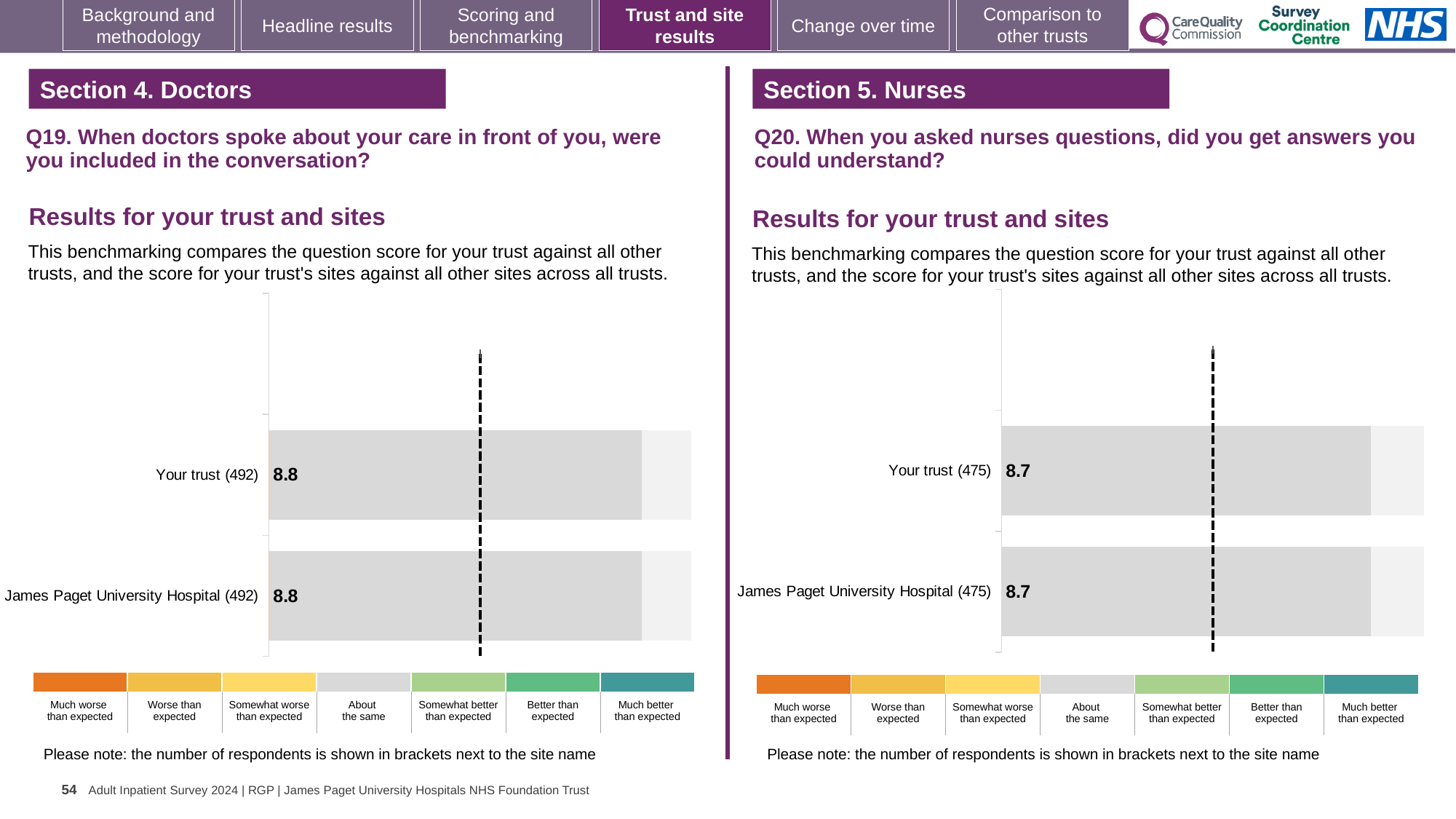
On the Q20 nurses chart (right), how many bars are plotted? 2 How many benchmark categories does the legend below the Q19 doctors chart (left) list? 7 Is the score for Your trust on the Q19 doctors chart (left) larger than, smaller than, or equal to the score for Your trust on the Q20 nurses chart (right)? Larger On the Q19 doctors chart (left), what is the score for Your trust? 8.8 What kind of chart is shown on the Q19 doctors chart (left)? Bar chart On the Q19 doctors chart (left), what is the score for James Paget University Hospital? 8.8 On the Q20 nurses chart (right), how many respondents are shown in brackets for James Paget University Hospital? 475 On the Q20 nurses chart (right), what is the score for Your trust? 8.7 On the Q20 nurses chart (right), which benchmark category does the grey colour of the bars correspond to in the legend? About the same On the Q19 doctors chart (left), what is the difference between the score for Your trust and the score for James Paget University Hospital? 0 On the Q20 nurses chart (right), what is the score for James Paget University Hospital? 8.7 On the Q19 doctors chart (left), how many respondents are shown in brackets for Your trust? 492